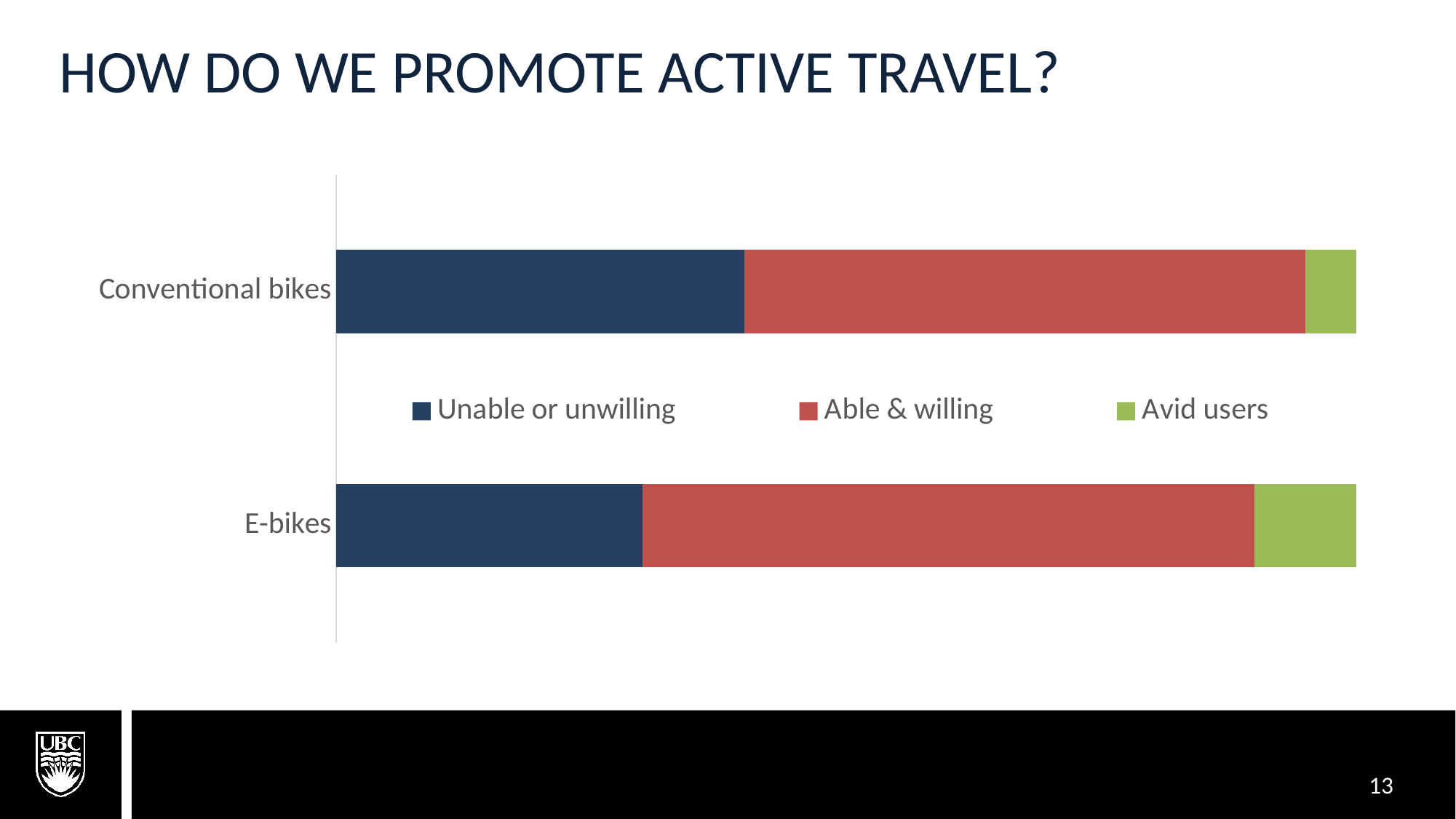
Which series is shown in green in the chart? Avid users Which series forms the smallest segment of the E-bikes bar? Avid users How many series does the legend list? 3 Which series forms the smallest segment of the Conventional bikes bar? Avid users What is the title of the slide containing the chart? HOW DO WE PROMOTE ACTIVE TRAVEL? Which category has the larger 'Avid users' segment, Conventional bikes or E-bikes? E-bikes How many categories are plotted on the chart? 2 What kind of chart is shown on the slide? Stacked bar chart Which series forms the largest segment of the E-bikes bar? Able & willing Which category has the larger 'Unable or unwilling' segment, Conventional bikes or E-bikes? Conventional bikes Which series forms the largest segment of the Conventional bikes bar? Able & willing